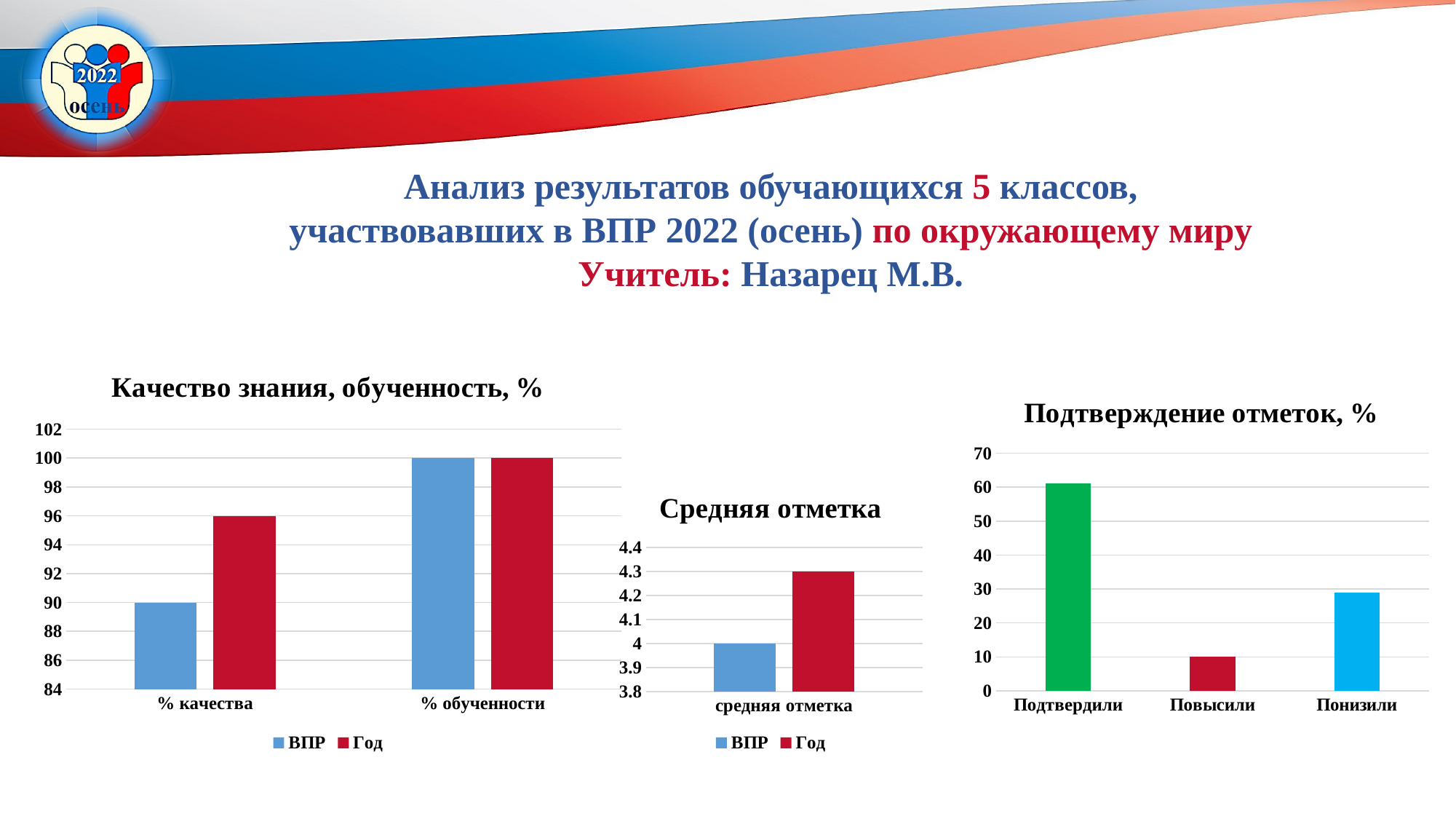
In the chart 'Качество знания, обученность, %', what is the difference between Год and ВПР for '% качества'? 6 In the chart 'Подтверждение отметок, %', what is the value for Повысили? 10 In the chart 'Средняя отметка', which is larger, ВПР or Год? Год In the chart 'Качество знания, обученность, %', what is the value for ВПР in the '% обученности' category? 100 In the chart 'Качество знания, обученность, %', how many series does the legend list? 2 In the chart 'Средняя отметка', what is the value for Год? 4.3 What kind of chart is 'Подтверждение отметок, %'? bar chart In the chart 'Качество знания, обученность, %', what is the value for ВПР in the '% качества' category? 90 In the chart 'Средняя отметка', what is the value for ВПР? 4 In the chart 'Подтверждение отметок, %', which category has the highest value? Подтвердили In the chart 'Качество знания, обученность, %', what is the value for Год in the '% качества' category? 96